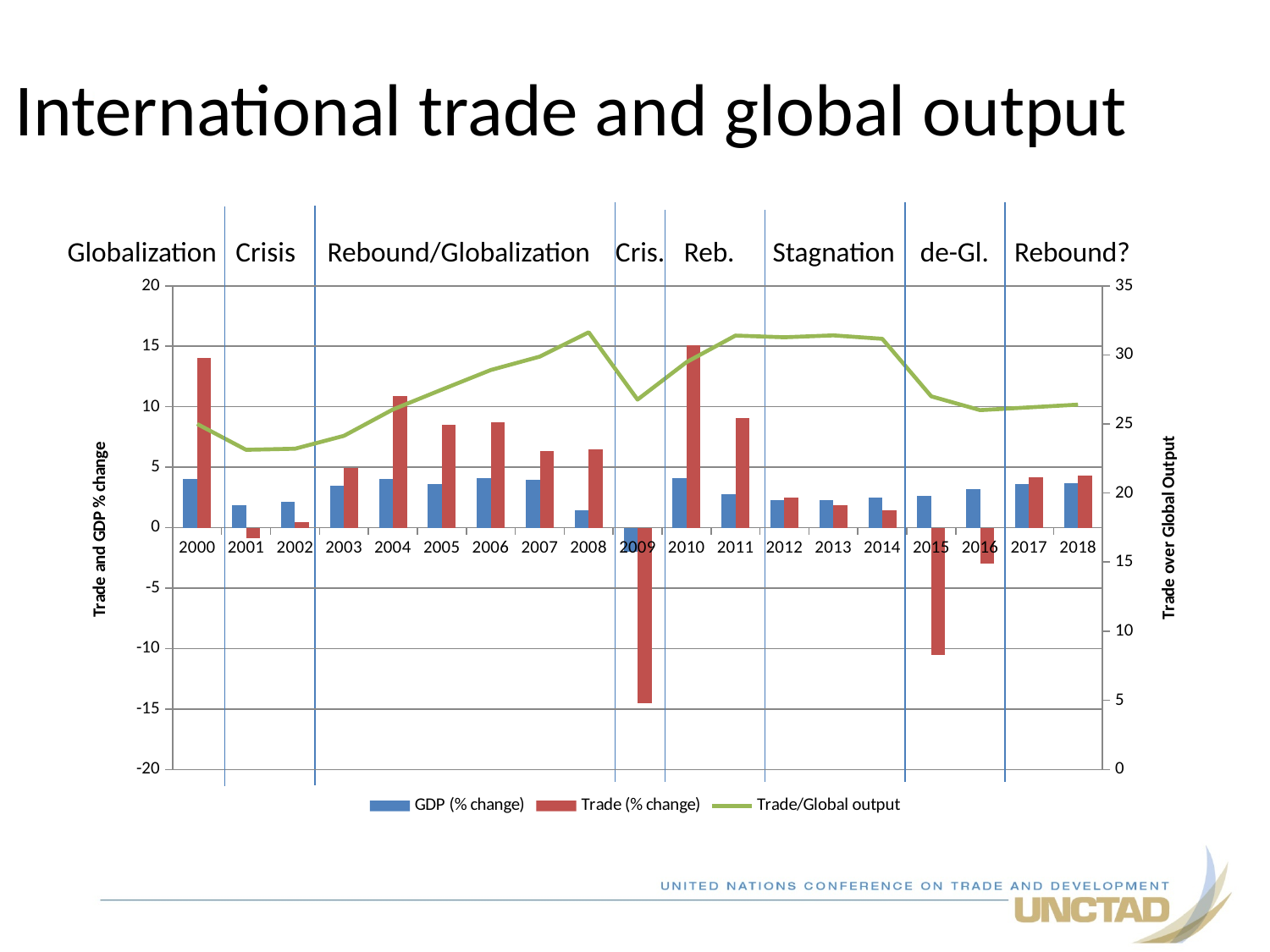
Does the Trade/Global output line rise or fall from 2014 to 2016? fall How many series does the legend list? 3 What kind of chart is shown on the slide? A combined bar and line chart In which year is GDP (% change) lowest? 2009 Is the Trade/Global output value for 2008 greater or less than 30 on the right axis? greater Which is larger in 2010, GDP (% change) or Trade (% change)? Trade (% change) In which year is Trade (% change) lowest? 2009 How many years are shown on the x axis? 19 Is the Trade (% change) value for 2000 greater or less than 10? greater In which year is Trade (% change) highest? 2010 What is the title of the left vertical axis? Trade and GDP % change Is the Trade (% change) value for 2009 greater or less than -10? less